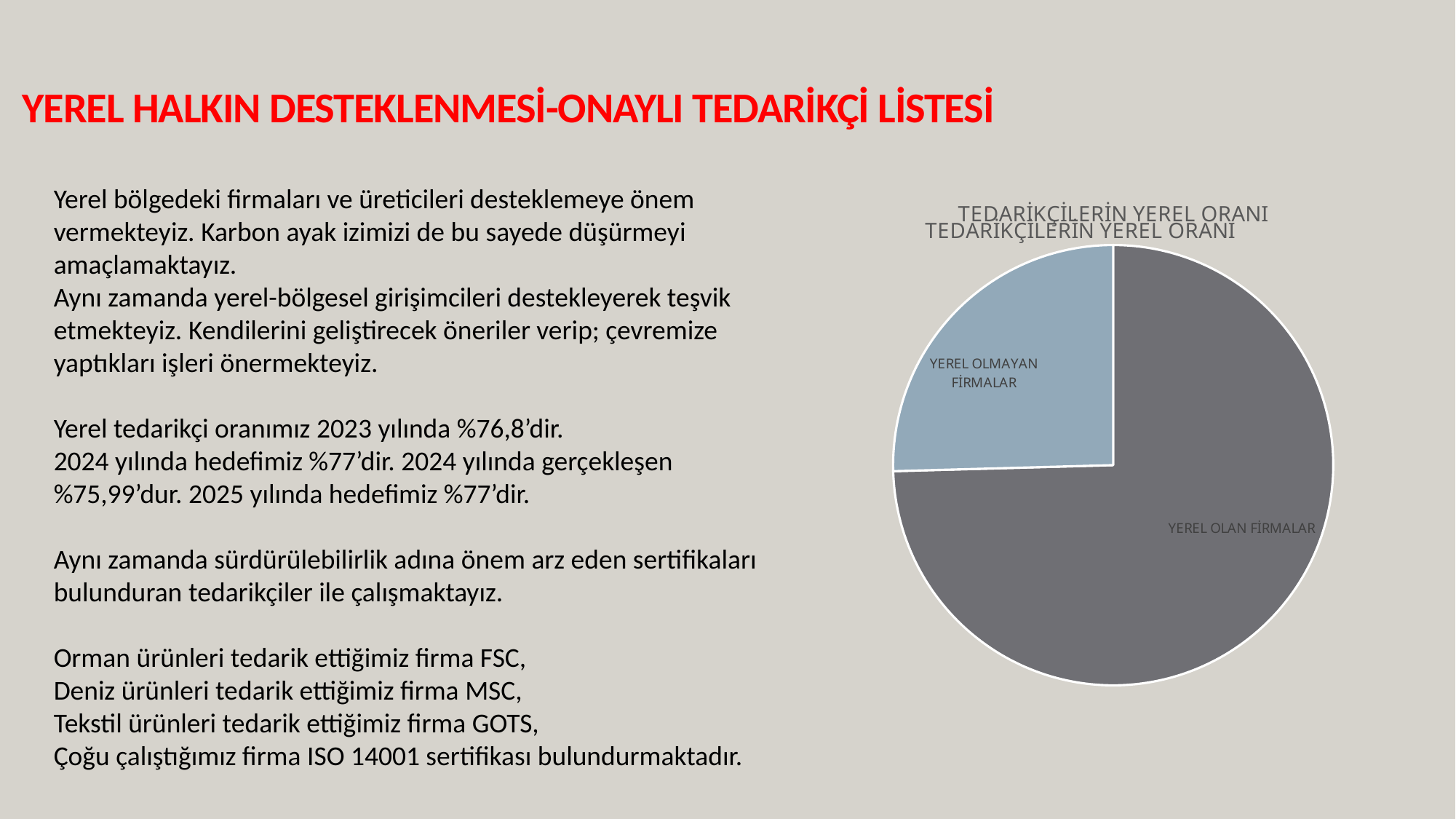
What is the title of the pie chart? TEDARİKÇİLERİN YEREL ORANI How many slices does the pie chart have? 2 Which slice of the pie chart is the largest? YEREL OLAN FİRMALAR Which slice of the pie chart is the smallest? YEREL OLMAYAN FİRMALAR What colour is the YEREL OLMAYAN FİRMALAR slice in the pie chart? Light blue-grey Does the YEREL OLAN FİRMALAR slice take up more or less than half of the pie chart? More In the pie chart, which slice is larger: YEREL OLAN FİRMALAR or YEREL OLMAYAN FİRMALAR? YEREL OLAN FİRMALAR What kind of chart is shown on the slide? Pie chart